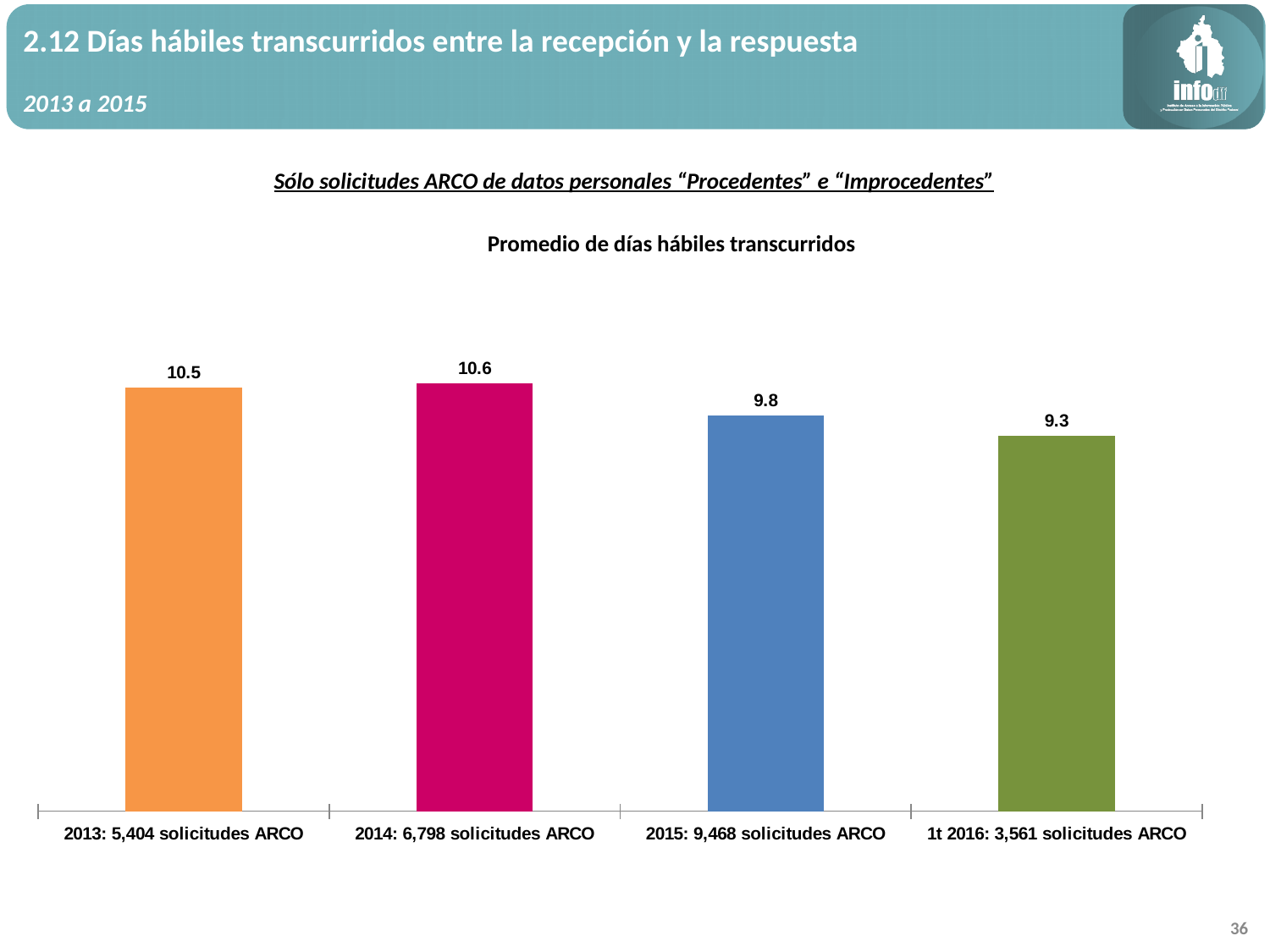
Which category has the lowest average of business days? 1t 2016: 3,561 solicitudes ARCO What is the title of the chart? Promedio de días hábiles transcurridos What is the difference between the 2013 value and the 1t 2016 value? 1.2 What is the difference between the 2014 value and the 2015 value? 0.8 What is the average number of business days for 2013: 5,404 solicitudes ARCO? 10.5 Which category has the highest average of business days? 2014: 6,798 solicitudes ARCO What kind of chart is shown on the slide? Bar chart What is the average number of business days for 1t 2016: 3,561 solicitudes ARCO? 9.3 What is the average number of business days for 2015: 9,468 solicitudes ARCO? 9.8 Which is larger, the value for 2015 or the value for 1t 2016? 2015 What is the average number of business days for 2014: 6,798 solicitudes ARCO? 10.6 How many categories are shown in the chart? 4